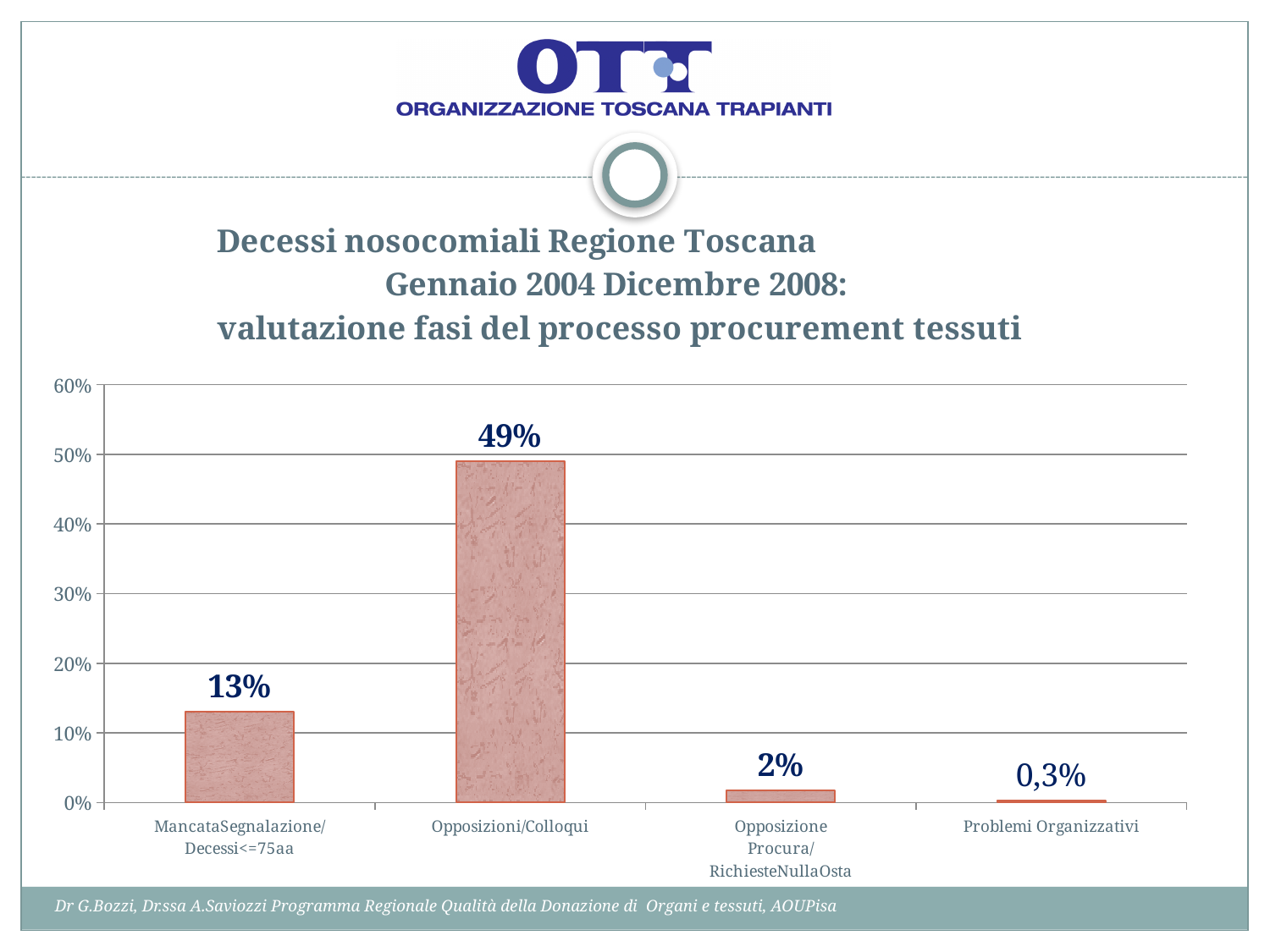
What is the highest value shown on the y axis? 60% What is the difference between the values for Opposizioni/Colloqui and MancataSegnalazione/Decessi<=75aa? 36% What kind of chart is shown on the slide? bar chart What is the value for MancataSegnalazione/Decessi<=75aa? 13% How many categories are shown on the x axis? 4 Is the value for Opposizioni/Colloqui greater or less than 40%? greater What is the value for Opposizione Procura/RichiesteNullaOsta? 2% What is the value for Opposizioni/Colloqui? 49% Which category has the highest value? Opposizioni/Colloqui Which is larger, the value for MancataSegnalazione/Decessi<=75aa or the value for Opposizione Procura/RichiesteNullaOsta? MancataSegnalazione/Decessi<=75aa What is the value for Problemi Organizzativi? 0,3% Which category has the lowest value? Problemi Organizzativi